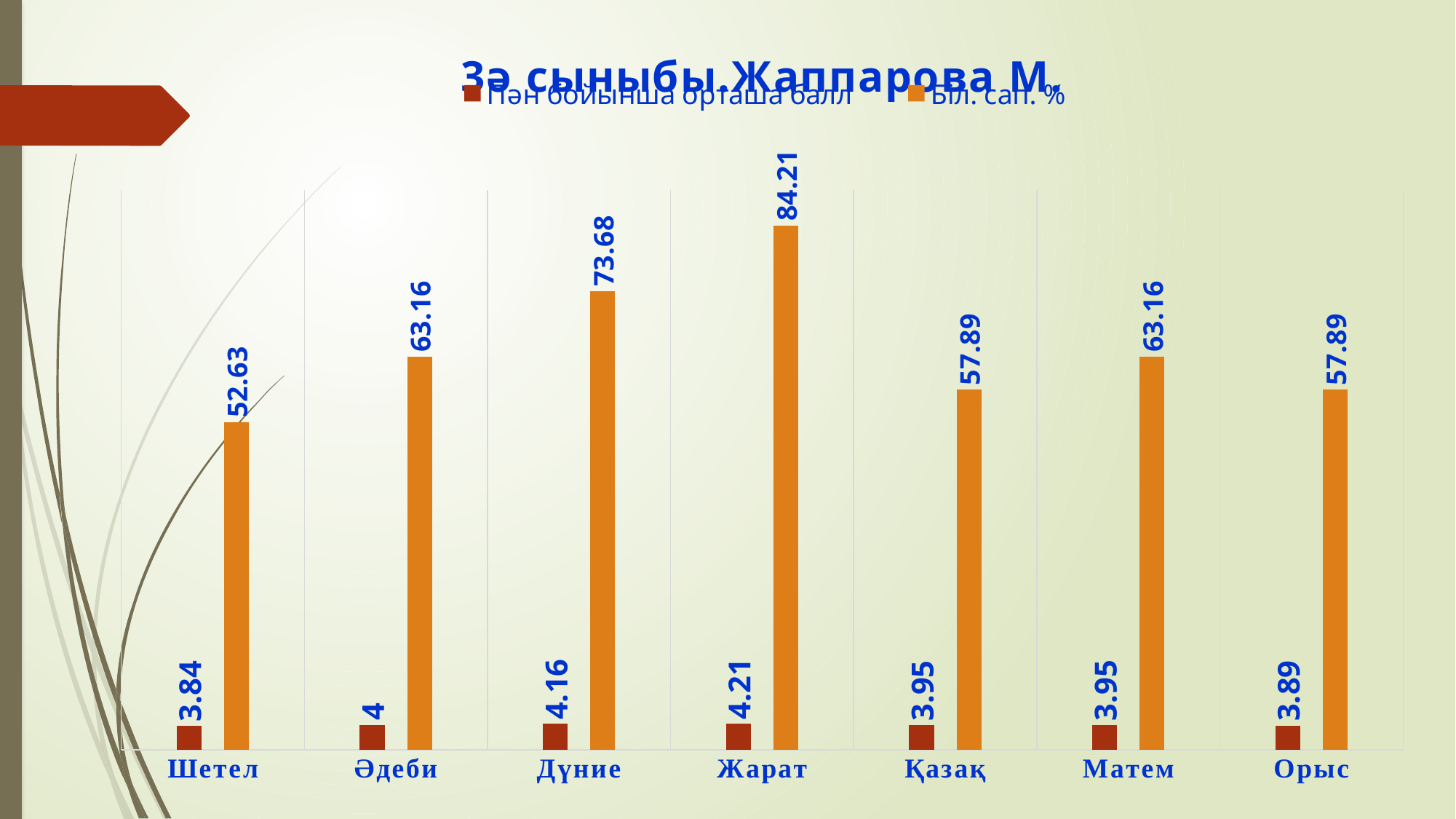
What is the value of Біл. сап. % for Шетел? 52.63 Which category has the highest Біл. сап. % value? Жарат What kind of chart is shown on the slide? Bar chart What is the value of Пән бойынша орташа балл for Әдеби? 4 What is the value of Пән бойынша орташа балл for Дүние? 4.16 Which category has the lowest Біл. сап. % value? Шетел What is the value of Біл. сап. % for Жарат? 84.21 Which is larger, the Біл. сап. % value for Әдеби or for Қазақ? Әдеби Which category has the lowest Пән бойынша орташа балл value? Шетел How many series does the legend list? 2 How many categories are shown on the x axis? 7 What is the difference between the Біл. сап. % values for Жарат and Дүние? 10.53